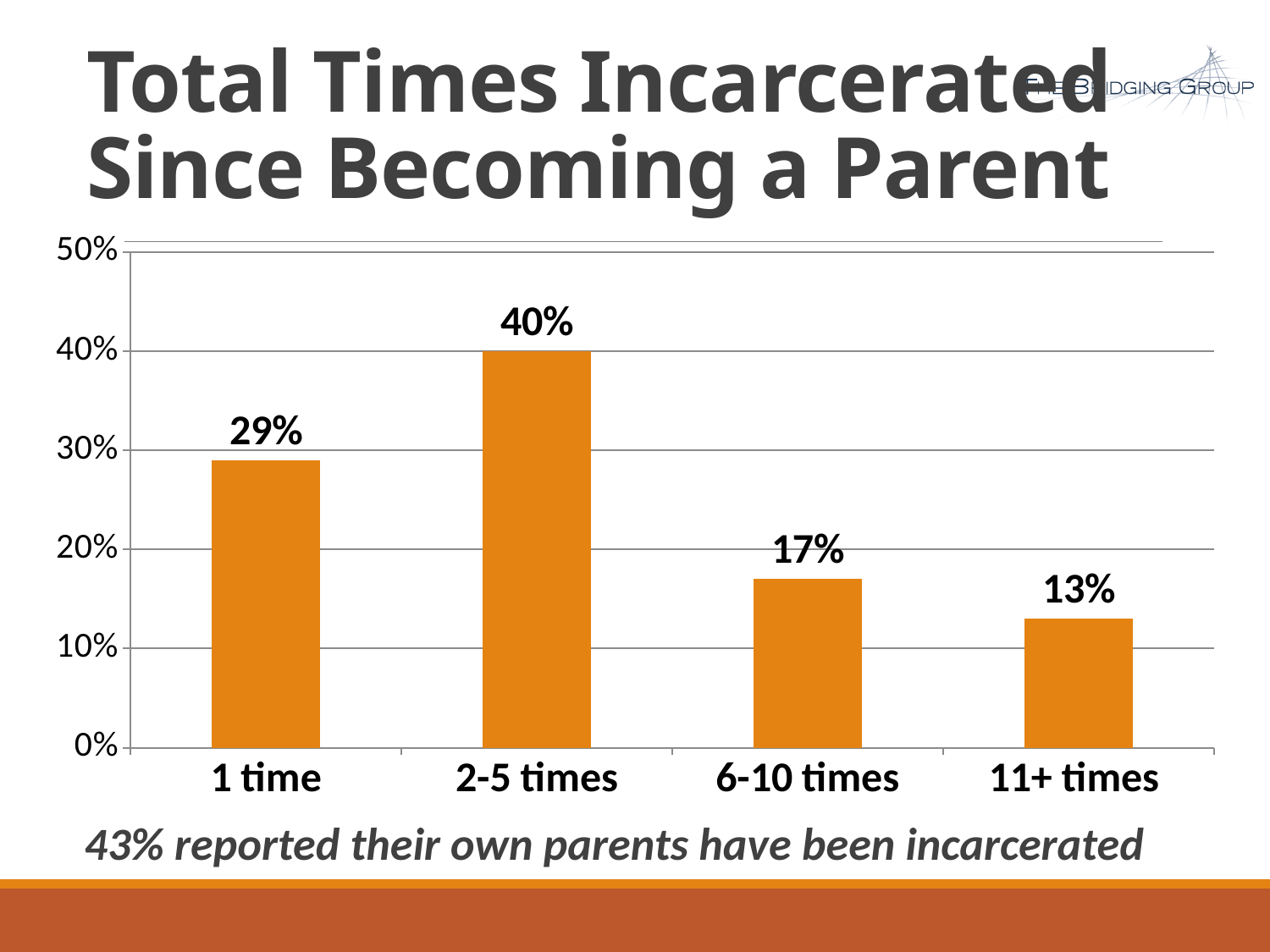
What is the difference between the values for 2-5 times and 1 time? 11% Which category has the lowest value? 11+ times What is the title of the chart on the slide? Total Times Incarcerated Since Becoming a Parent What is the value for the 6-10 times category? 17% What kind of chart is shown on the slide? Bar chart What is the value for the 2-5 times category? 40% How many categories are shown on the x axis? 4 What percentage of respondents were incarcerated 1 time since becoming a parent? 29% Which category has the highest value? 2-5 times Which is larger, the value for 1 time or the value for 6-10 times? 1 time What is the difference between the values for 6-10 times and 11+ times? 4% What is the value for the 11+ times category? 13%